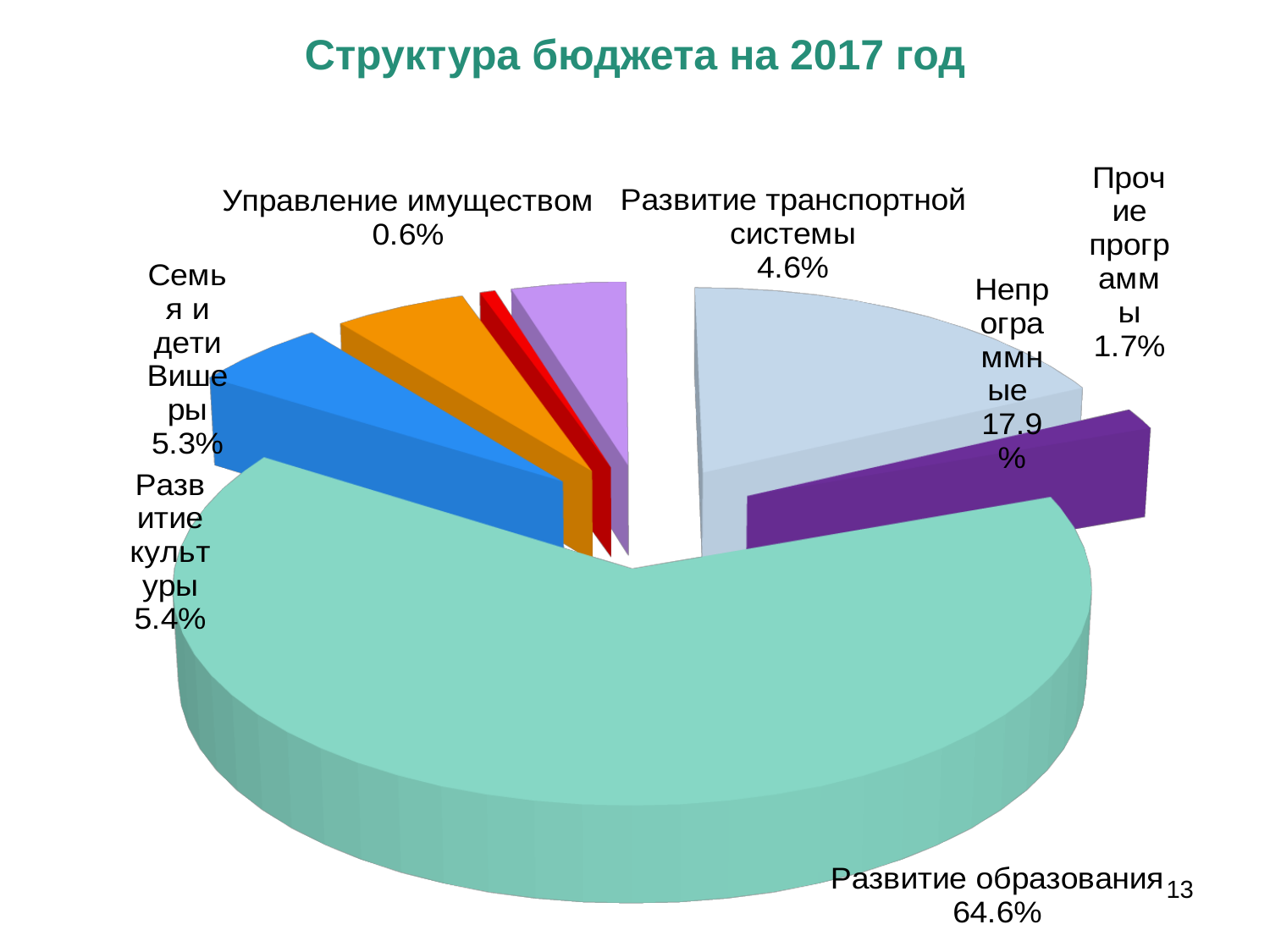
What kind of chart is shown on the slide? pie chart What share of the budget goes to Развитие образования? 64.6% How many slices does the pie chart have? 7 What is the difference between the shares of Развитие культуры and Семья и дети Вишеры? 0.1% What is the value shown for Непрограммные? 17.9% What is the value shown for Развитие транспортной системы? 4.6% What is the difference between the shares of Развитие образования and Непрограммные? 46.7% Which is larger, the share for Прочие программы or the share for Развитие транспортной системы? Развитие транспортной системы Which category has the smallest share of the budget? Управление имуществом What is the title of the chart? Структура бюджета на 2017 год What is the value shown for Управление имуществом? 0.6% Which category has the largest share of the budget? Развитие образования